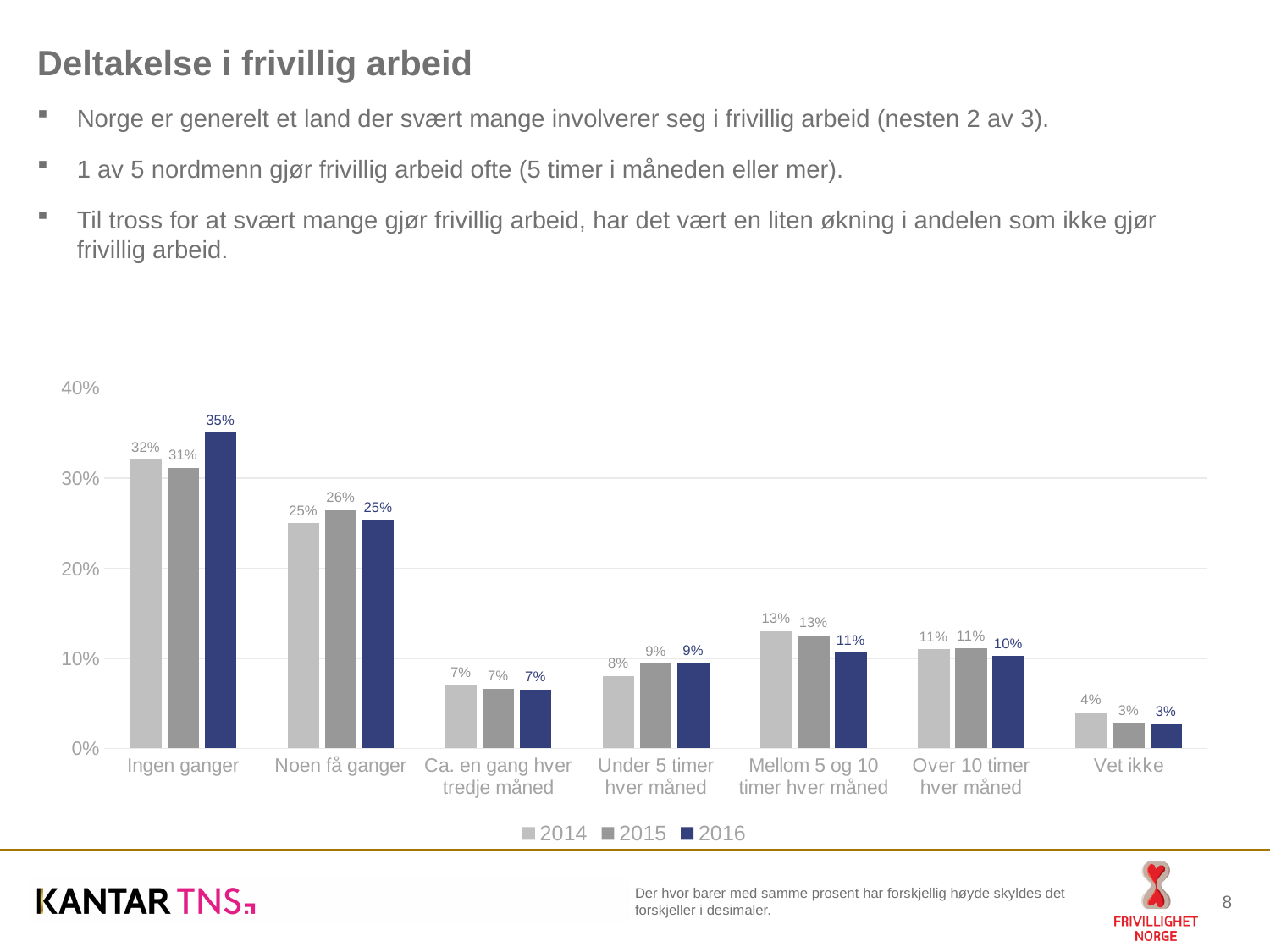
How many series does the legend list? 3 Which series is shown in dark blue in the legend? 2016 Which is larger: the 2014 value for "Mellom 5 og 10 timer hver måned" or the 2016 value for the same category? 2014 What is the value for 2016 in the "Mellom 5 og 10 timer hver måned" category? 11% What is the value for 2015 in the "Noen få ganger" category? 26% What is the difference between the 2016 and 2014 values for "Ingen ganger"? 3% What is the value for 2016 in the "Ingen ganger" category? 35% Which category has the lowest value for 2014? Vet ikke How many categories are shown on the x axis? 7 What kind of chart is shown on the slide? Bar chart Which category has the highest value for 2016? Ingen ganger What is the value for 2014 in the "Vet ikke" category? 4%